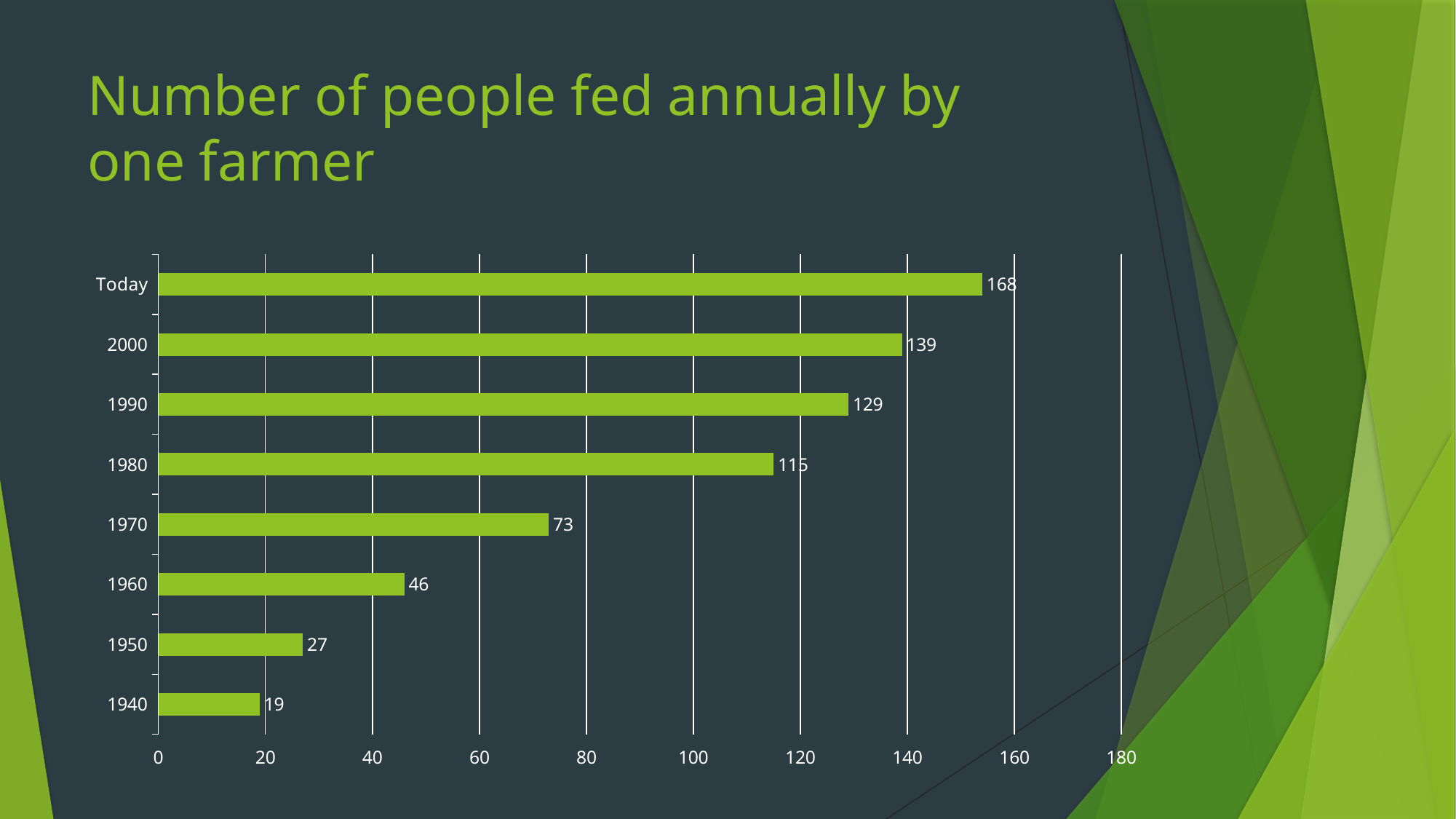
What is the difference between the value for 1990 and the value for 1960? 83 Is the value for 1980 greater or less than 100? greater Do the values rise or fall from 1940 to Today? rise What is the value shown for 1970? 73 Which category has the lowest value? 1940 What is the difference between the value for Today and the value for 2000? 29 How many people are fed annually by one farmer today, according to the chart? 168 What is the value shown for 1940? 19 Which is larger, the value for 1960 or the value for 1950? 1960 What kind of chart is shown on the slide? bar chart Which category has the highest value? Today How many categories are shown on the chart? 8